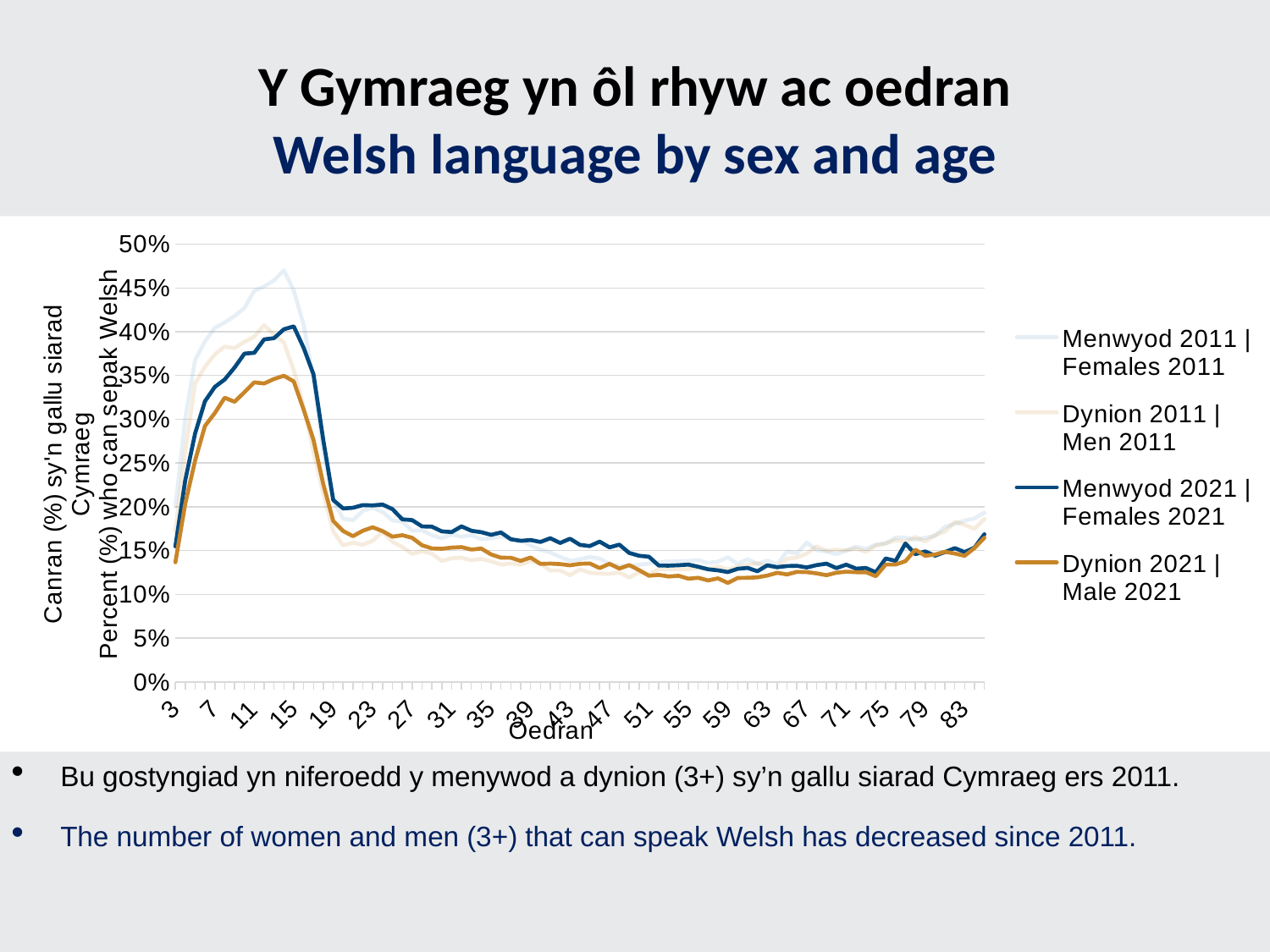
Is the value for Females 2011 at age 15 greater or less than 40%? greater Is the value for Females 2021 at age 15 greater or less than 35%? greater Is the value for Male 2021 at age 15 greater or less than 30%? greater How many series does the legend list? 4 At age 15, which is higher: Females 2021 or Male 2021? Females 2021 What is the label on the x axis of the chart? Oedran At age 11, which is higher: Females 2011 or Females 2021? Females 2011 Do the values for Females 2021 rise or fall between age 15 and age 19? fall What kind of chart is shown on the slide? line chart Which series is drawn in the dark blue line? Menwyod 2021 | Females 2021